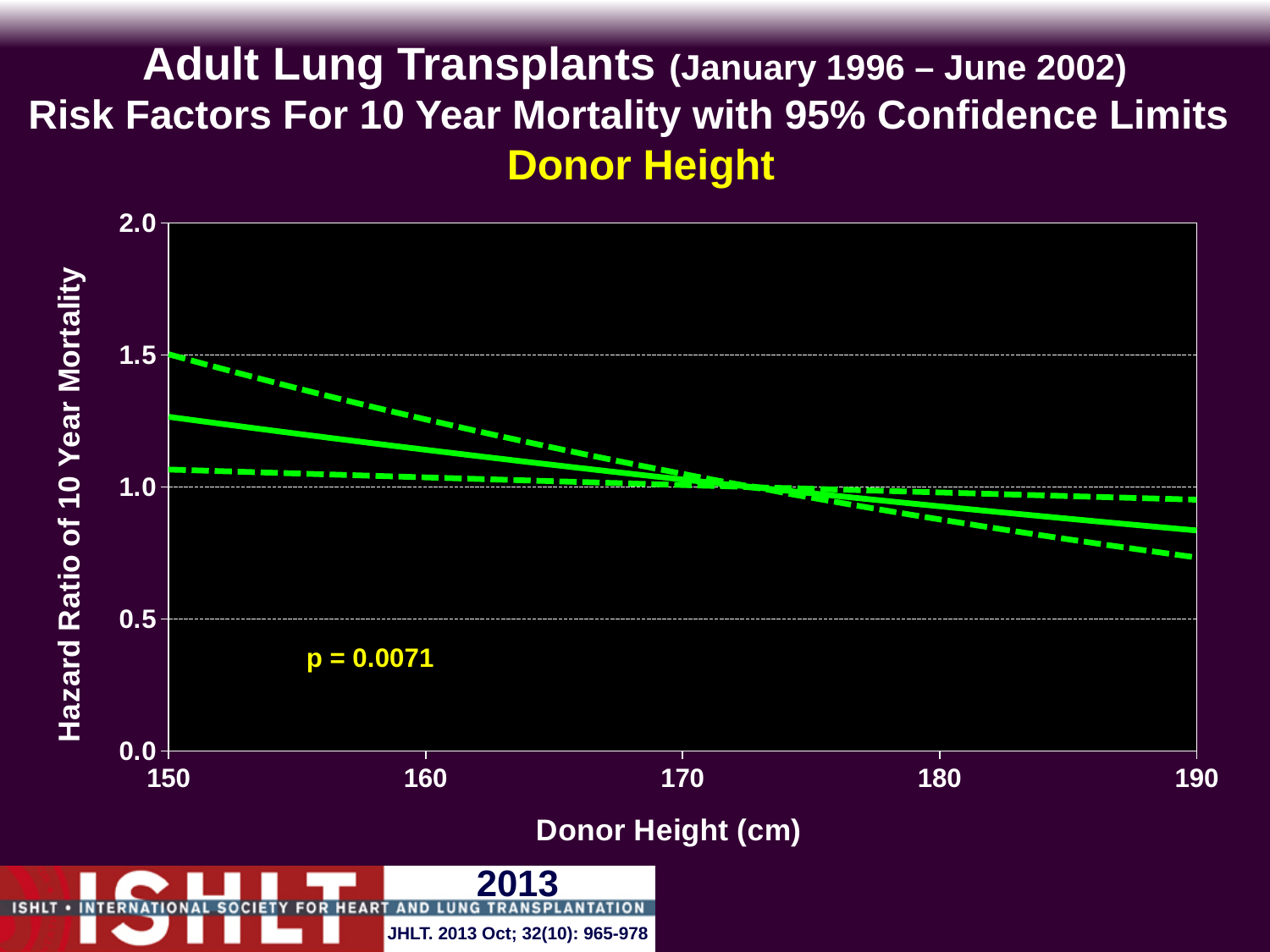
Does the hazard ratio of 10 year mortality rise or fall as donor height increases from 150 cm to 190 cm? fall What is the lowest donor height shown on the x axis? 150 Is the hazard ratio (solid line) at a donor height of 190 cm greater or less than 1.0? less What kind of chart is shown on the slide? line chart What is the highest value shown on the y axis? 2.0 What p-value is printed on the chart? p = 0.0071 Is the lower 95% confidence limit at a donor height of 190 cm greater or less than 0.5? greater Is the hazard ratio (solid line) at a donor height of 160 cm greater or less than 1.5? less What is the label of the x axis? Donor Height (cm) How many lines are plotted on the chart? 3